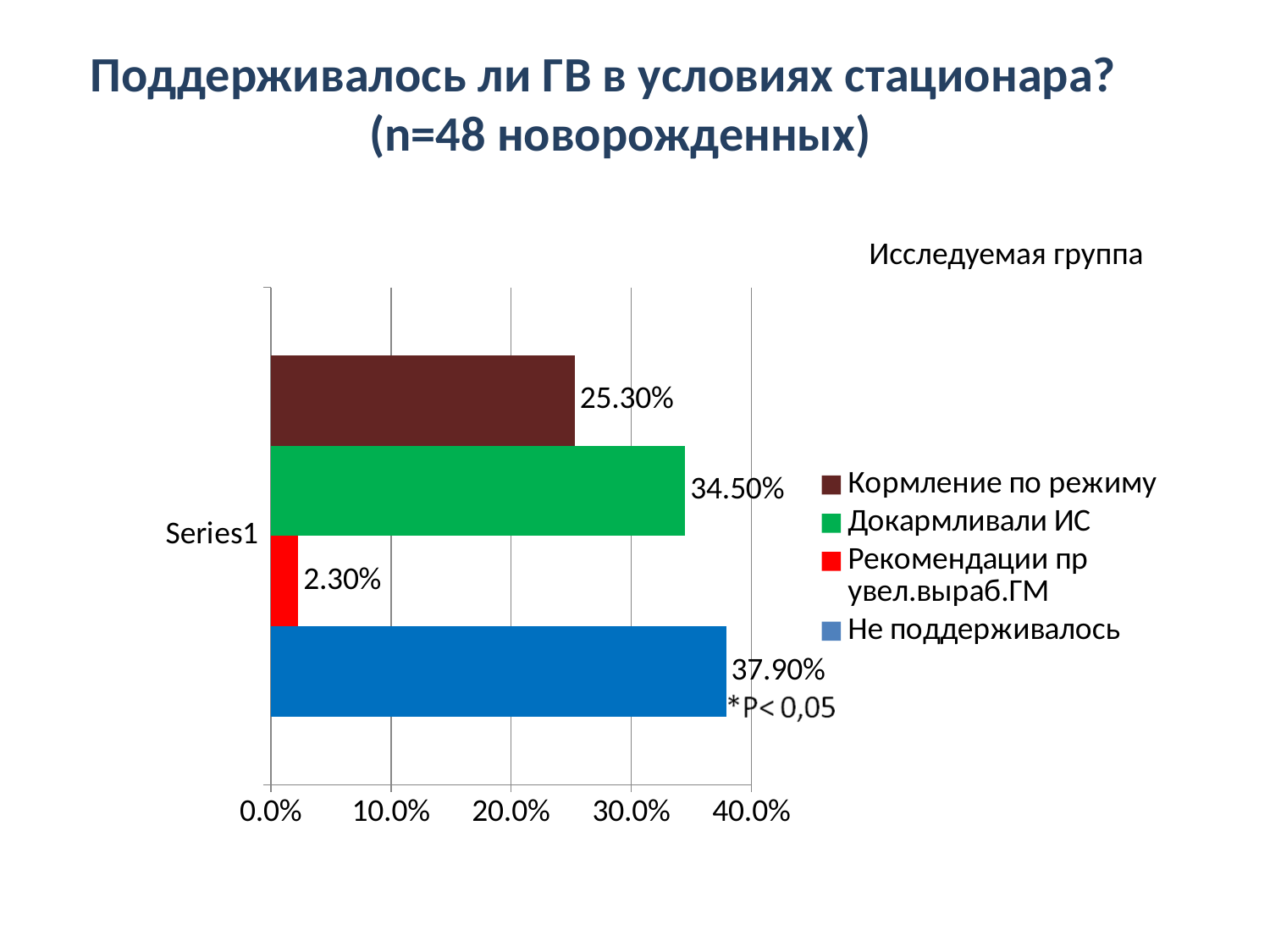
Is the value for Кормление по режиму greater or less than 30.0%? less What value is shown for Рекомендации пр увел.выраб.ГМ? 2.30% Which series has the lowest value? Рекомендации пр увел.выраб.ГМ Which is larger, the value for Кормление по режиму or the value for Докармливали ИС? Докармливали ИС What kind of chart is shown on the slide? Bar chart What is the difference between the values for Докармливали ИС and Кормление по режиму? 9.20% What is the difference between the values for Не поддерживалось and Докармливали ИС? 3.40% What value is shown for Докармливали ИС? 34.50% What value is shown for Не поддерживалось? 37.90% What value is shown for Кормление по режиму? 25.30% How many series does the legend list? 4 Which series has the highest value? Не поддерживалось